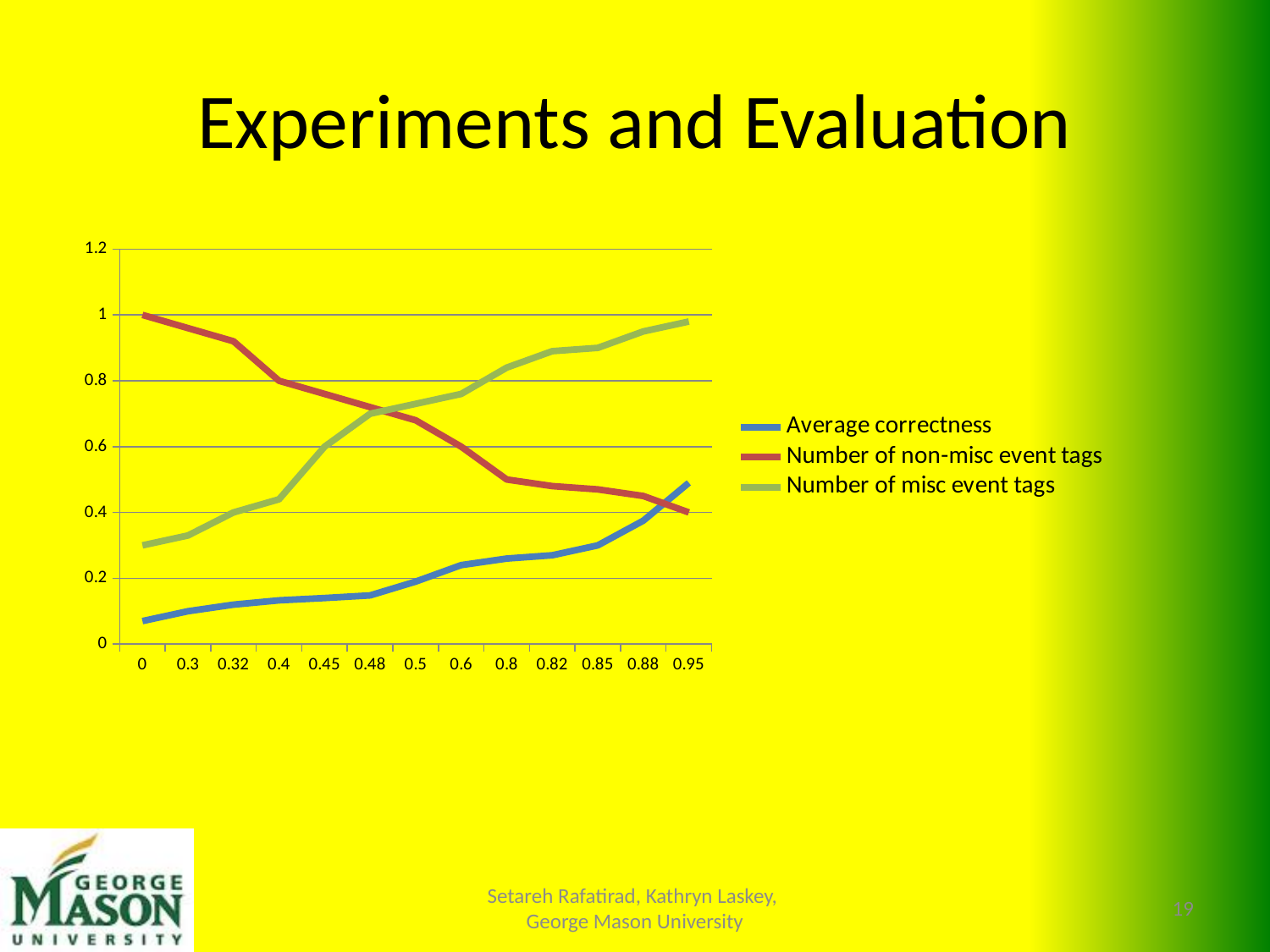
Is the value of Number of misc event tags at x = 0.95 greater or less than 0.8? greater How many points are plotted along the x axis for each series? 13 What kind of chart is shown on the slide? line chart Does Number of misc event tags rise or fall as x increases from 0 to 0.95? rise What is the value of Number of non-misc event tags at x = 0? 1 At x = 0.95, which is larger: Number of misc event tags or Number of non-misc event tags? Number of misc event tags How many series does the chart's legend list? 3 Does Average correctness rise or fall as x increases from 0 to 0.95? rise Is the value of Number of non-misc event tags at x = 0.95 greater or less than 0.6? less Is the value of Average correctness at x = 0 greater or less than 0.2? less At x = 0, which is larger: Number of non-misc event tags or Number of misc event tags? Number of non-misc event tags Does Number of non-misc event tags rise or fall as x increases from 0 to 0.95? fall